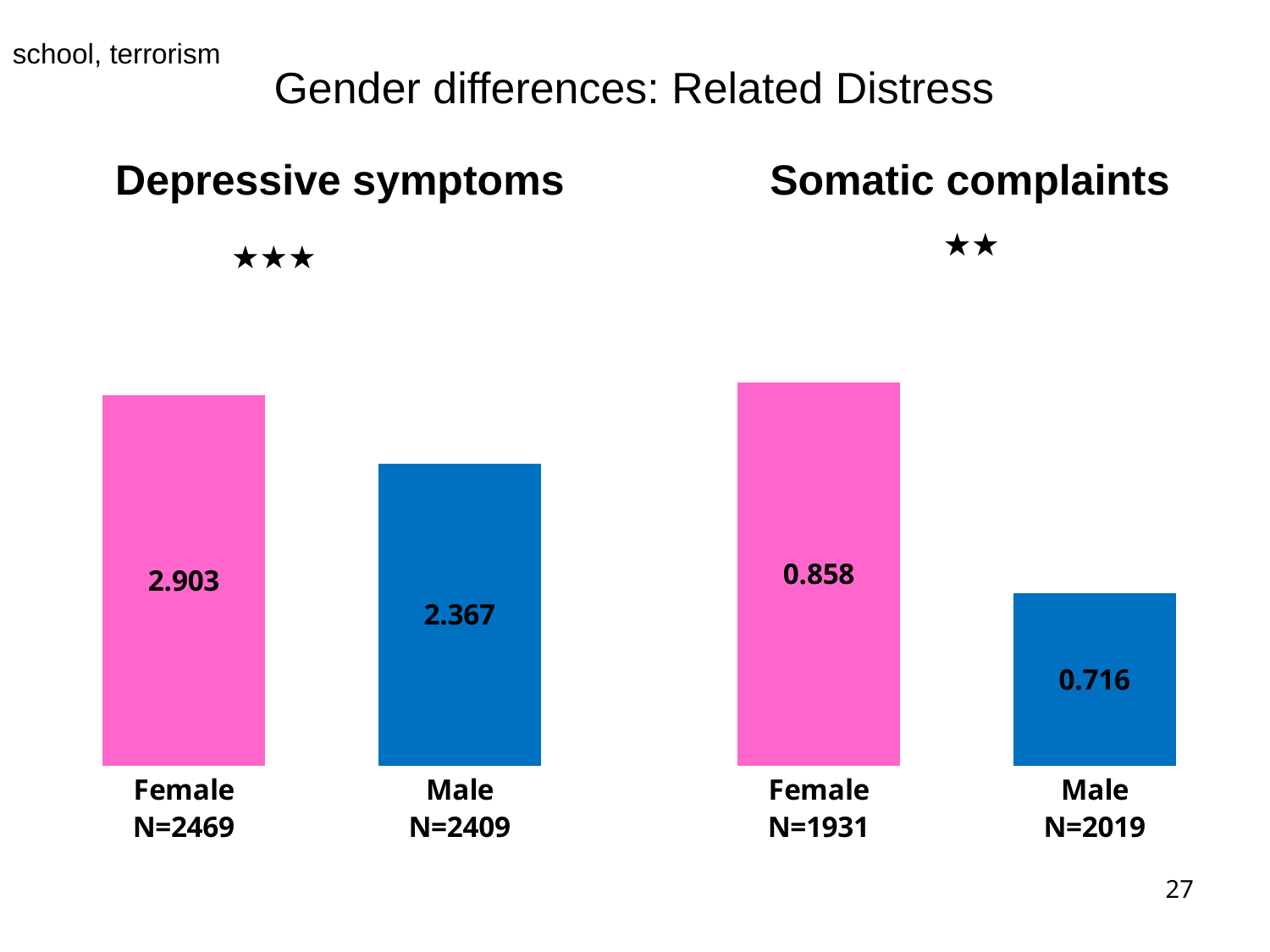
In the Depressive symptoms chart, what sample size is shown under the Female bar? N=2469 In the Somatic complaints chart, what is the value for Female? 0.858 How many bars are in the Depressive symptoms chart? 2 In the Somatic complaints chart, is the value for Female larger or smaller than the value for Male? larger In the Depressive symptoms chart, what is the difference between the Female and Male values? 0.536 In the Depressive symptoms chart, what is the value for Female? 2.903 In the Somatic complaints chart, which category has the lower value? Male In the Depressive symptoms chart, which category has the higher value? Female In the Somatic complaints chart, what is the difference between the Female and Male values? 0.142 In the Depressive symptoms chart, what is the value for Male? 2.367 What kind of chart is the Somatic complaints chart? bar chart In the Somatic complaints chart, what is the value for Male? 0.716